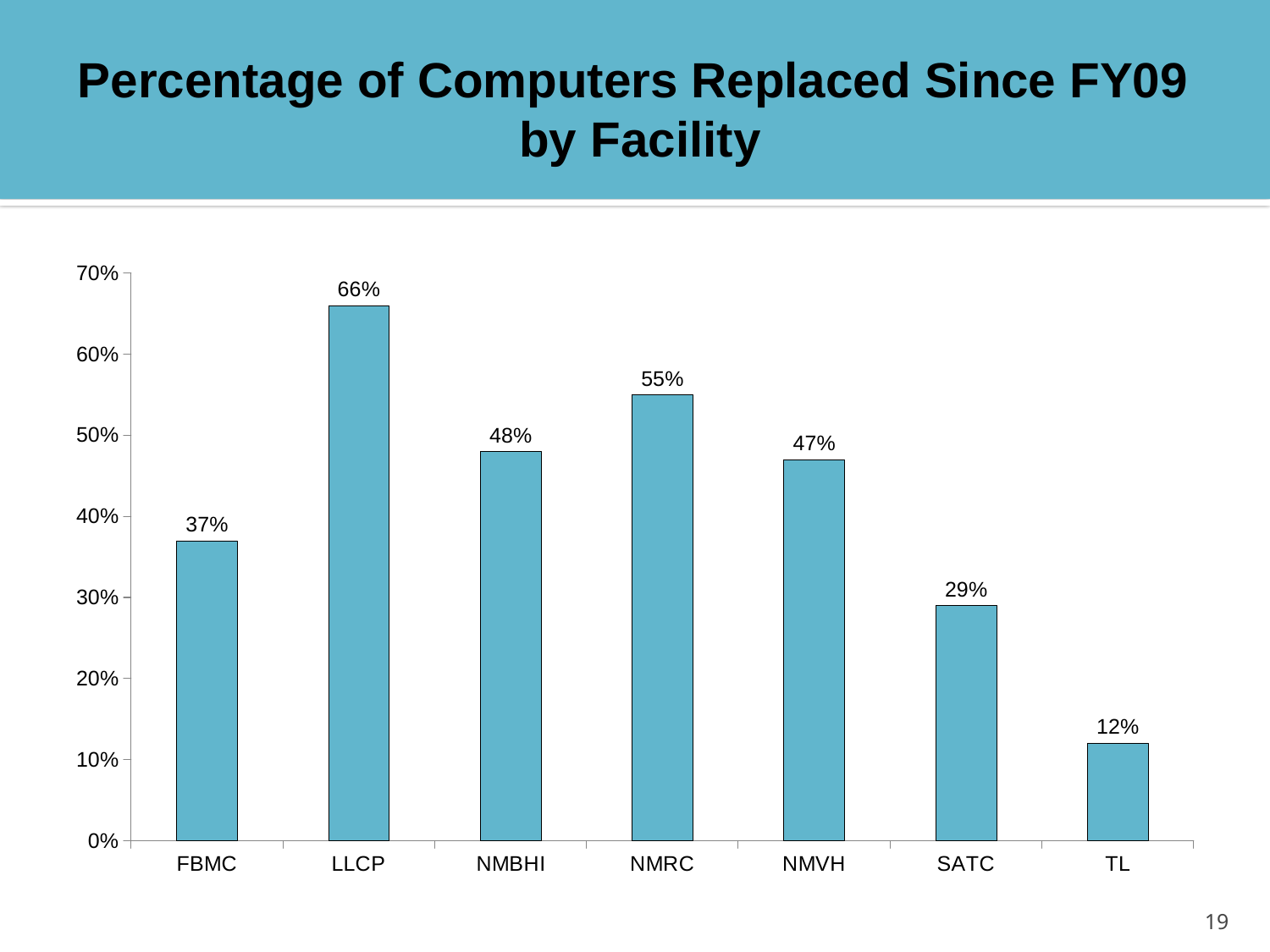
What is the difference between the values for LLCP and TL? 54% Is the value for FBMC greater or less than 40%? less What percentage of computers were replaced at LLCP? 66% How many facilities are shown on the chart? 7 Which has a higher value, NMBHI or NMVH? NMBHI Which facility has the highest percentage of computers replaced? LLCP What is the difference between the values for NMRC and FBMC? 18% What kind of chart is shown on the slide? bar chart What is the value shown for NMVH? 47% Which facility has the lowest percentage of computers replaced? TL What is the title of the slide? Percentage of Computers Replaced Since FY09 by Facility What percentage is shown for SATC? 29%